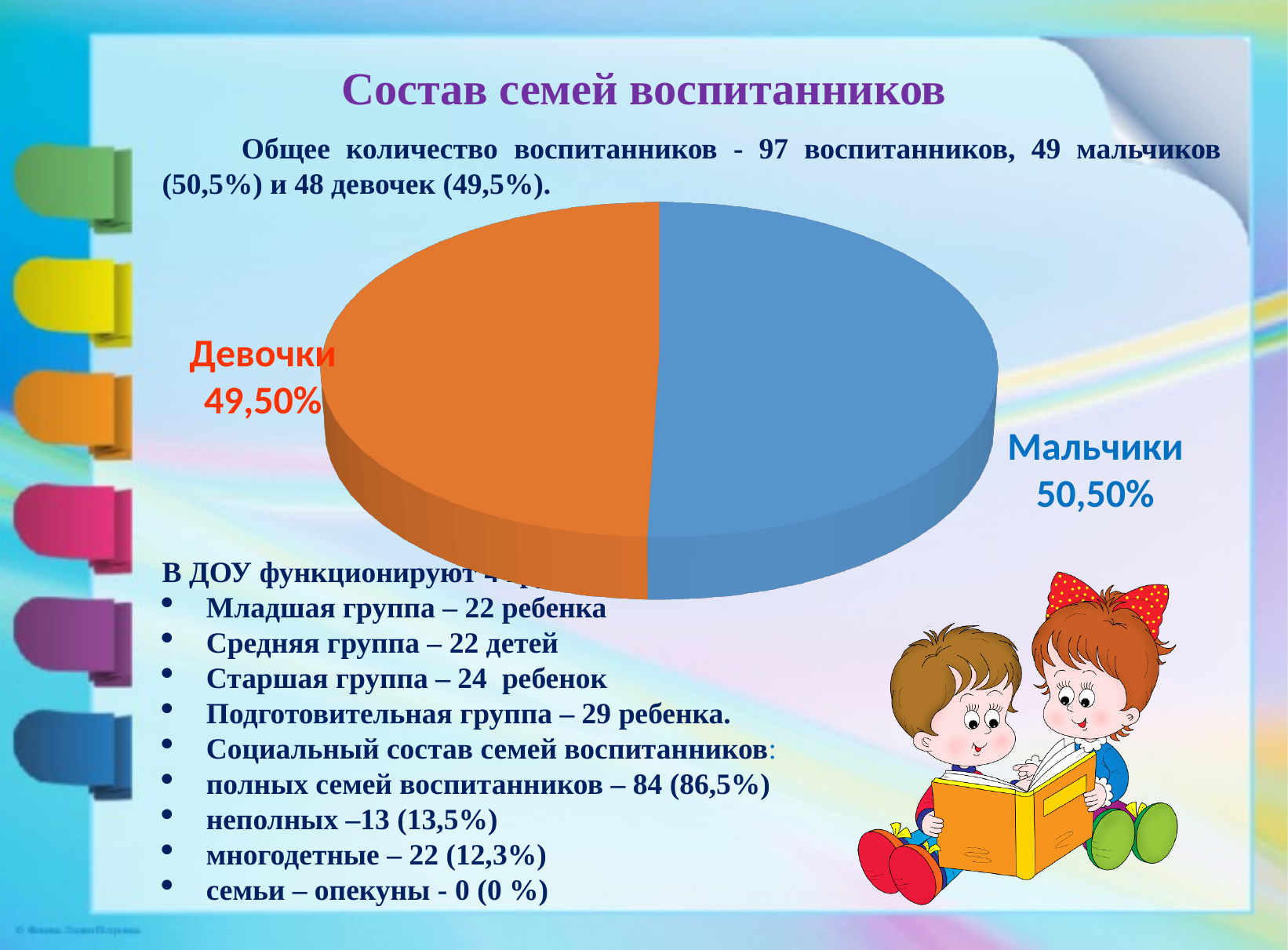
What kind of chart is shown on the slide? pie chart Which slice of the pie chart is larger, Мальчики or Девочки? Мальчики What colour is the Девочки slice in the pie chart? orange What is the share shown for Девочки in the pie chart? 49,50% Which category has the smallest share in the pie chart? Девочки Is the share for Мальчики greater or less than 50%? greater Is the share for Девочки greater or less than 50%? less What colour is the Мальчики slice in the pie chart? blue What is the difference in percentage points between the Мальчики and Девочки slices? 1,00% What is the share shown for Мальчики in the pie chart? 50,50% Which category has the largest share in the pie chart? Мальчики How many slices does the pie chart have? 2